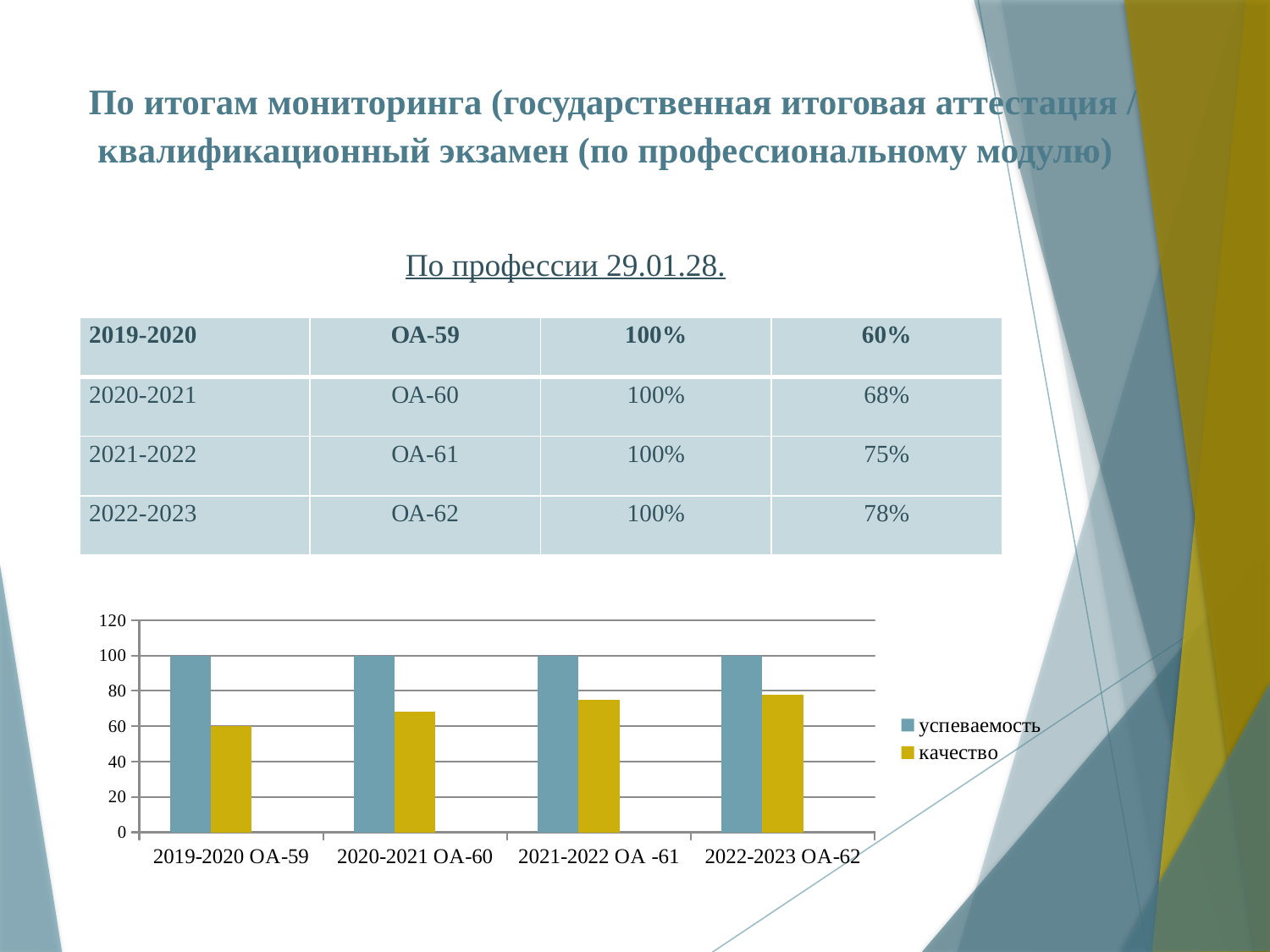
Which category has the highest value of качество? 2022-2023 ОА-62 How many series does the chart legend list? 2 Is the value of качество for 2019-2020 ОА-59 greater or less than 80? less What kind of chart is shown on the slide? bar chart Is the value of качество for 2022-2023 ОА-62 greater or less than 60? greater What is the value of успеваемость for 2021-2022 ОА -61 in the chart? 100 Which series is shown in yellow in the chart? качество Which category has the lowest value of качество? 2019-2020 ОА-59 How many categories are shown on the x axis of the chart? 4 Is the value of качество for 2020-2021 ОА-60 greater or less than 80? less Do the values of качество rise or fall from 2019-2020 ОА-59 to 2022-2023 ОА-62? rise Which is larger for 2020-2021 ОА-60: успеваемость or качество? успеваемость